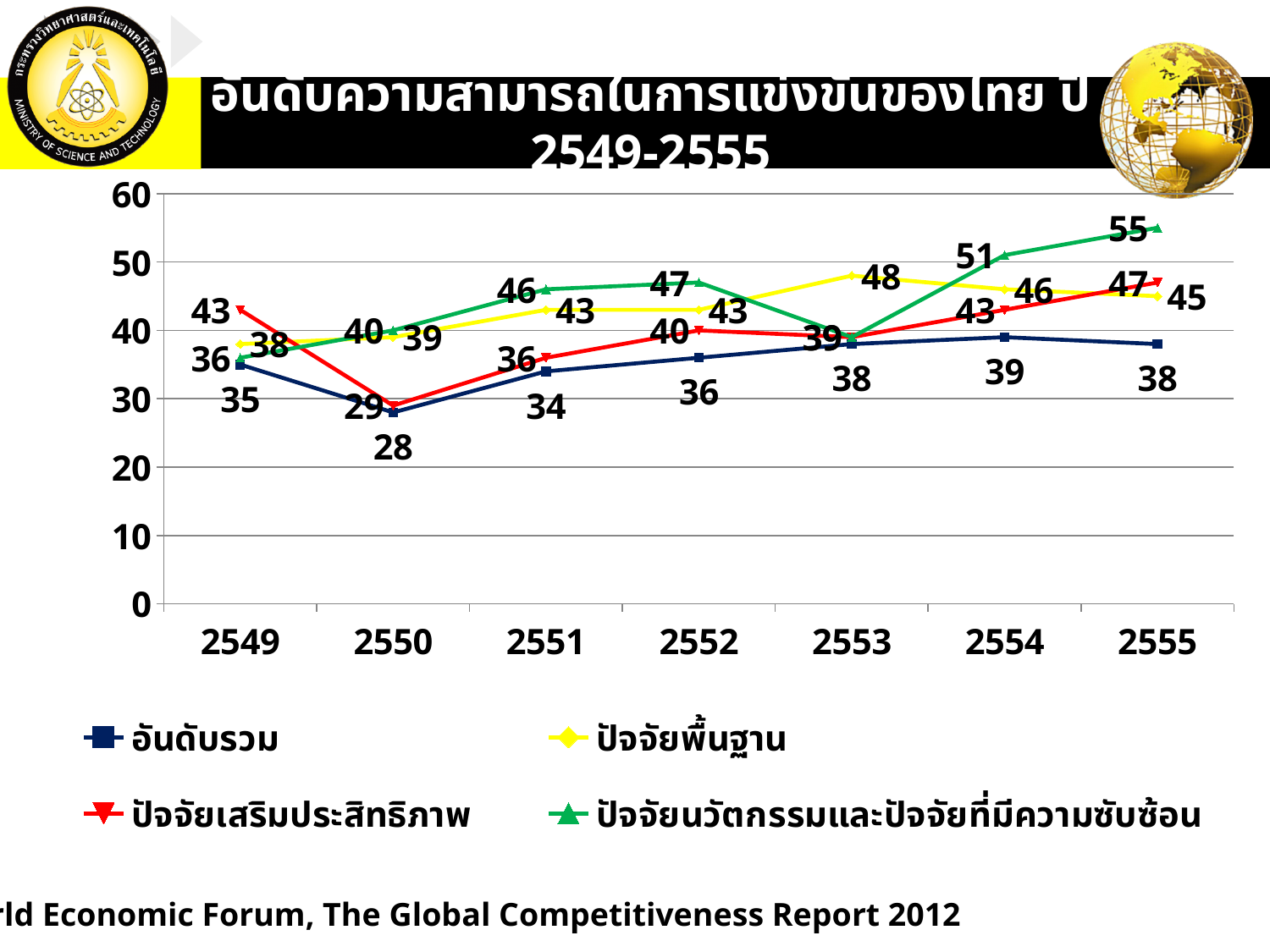
What kind of chart is shown on the slide? Line chart In which year is the value of อันดับรวม lowest? 2550 What is the difference between ปัจจัยนวัตกรรมและปัจจัยที่มีความซับซ้อน and อันดับรวม in 2555? 17 What is the value of ปัจจัยเสริมประสิทธิภาพ in 2549? 43 In which year is the value of ปัจจัยนวัตกรรมและปัจจัยที่มีความซับซ้อน highest? 2555 How many series does the legend list? 4 What is the value of ปัจจัยนวัตกรรมและปัจจัยที่มีความซับซ้อน in 2555? 55 Which is larger in 2554: ปัจจัยพื้นฐาน or ปัจจัยเสริมประสิทธิภาพ? ปัจจัยพื้นฐาน What is the value of ปัจจัยพื้นฐาน in 2553? 48 How many years are plotted along the x axis? 7 What is the value of อันดับรวม in 2550? 28 Does the value of ปัจจัยนวัตกรรมและปัจจัยที่มีความซับซ้อน rise or fall from 2553 to 2555? Rise